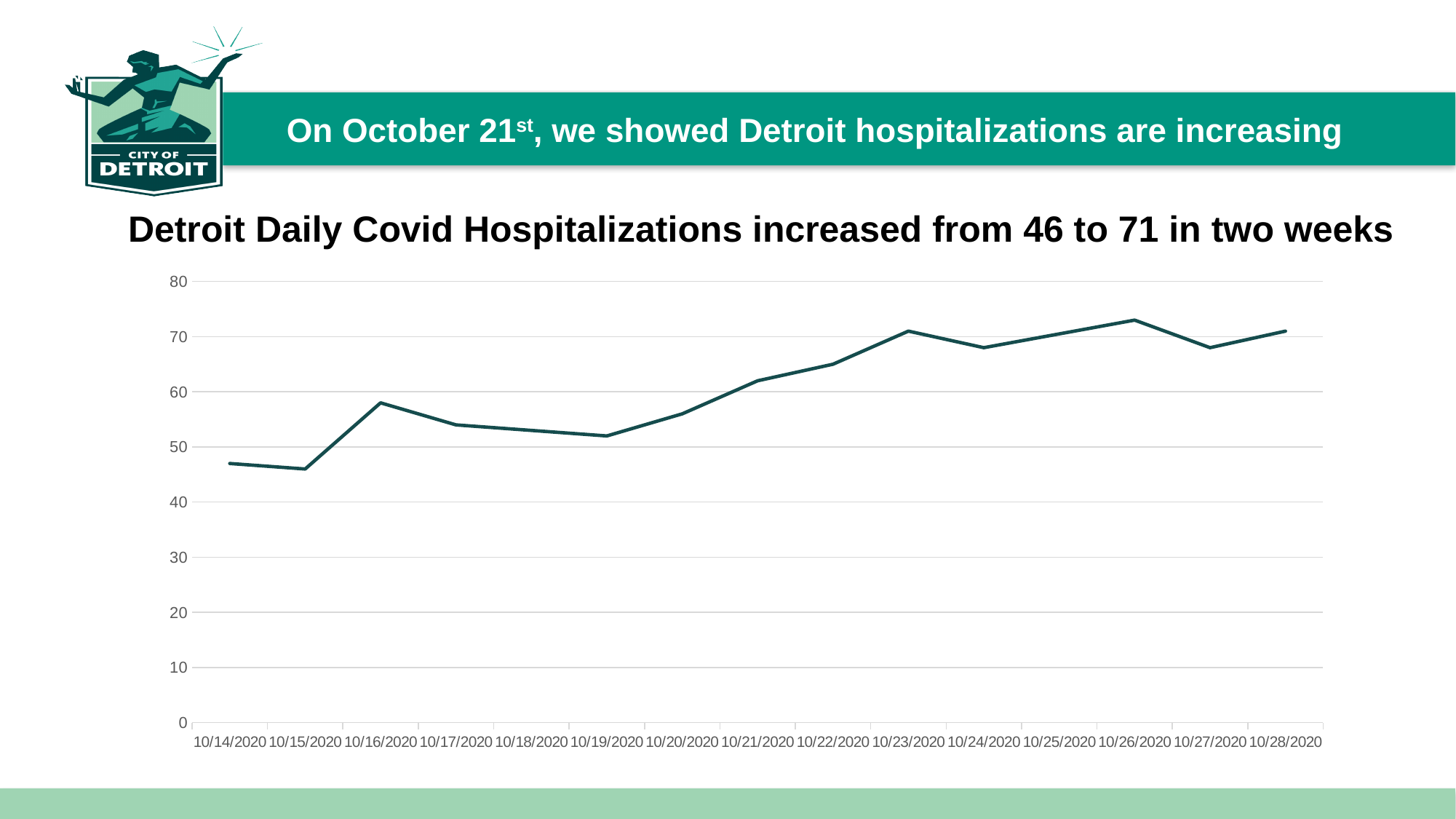
Overall, do the values rise or fall from 10/14/2020 to 10/28/2020? Rise What is the title of the chart? Detroit Daily Covid Hospitalizations increased from 46 to 71 in two weeks What kind of chart is shown on the slide? Line chart Is the value for 10/14/2020 greater or less than 50? less Is the value for 10/22/2020 greater or less than 60? greater Is the value for 10/19/2020 greater or less than 60? less On which date is the plotted value highest? 10/26/2020 How many dates are plotted along the x axis of the chart? 15 Which is larger, the value for 10/16/2020 or the value for 10/19/2020? 10/16/2020 Which is larger, the value for 10/21/2020 or the value for 10/17/2020? 10/21/2020